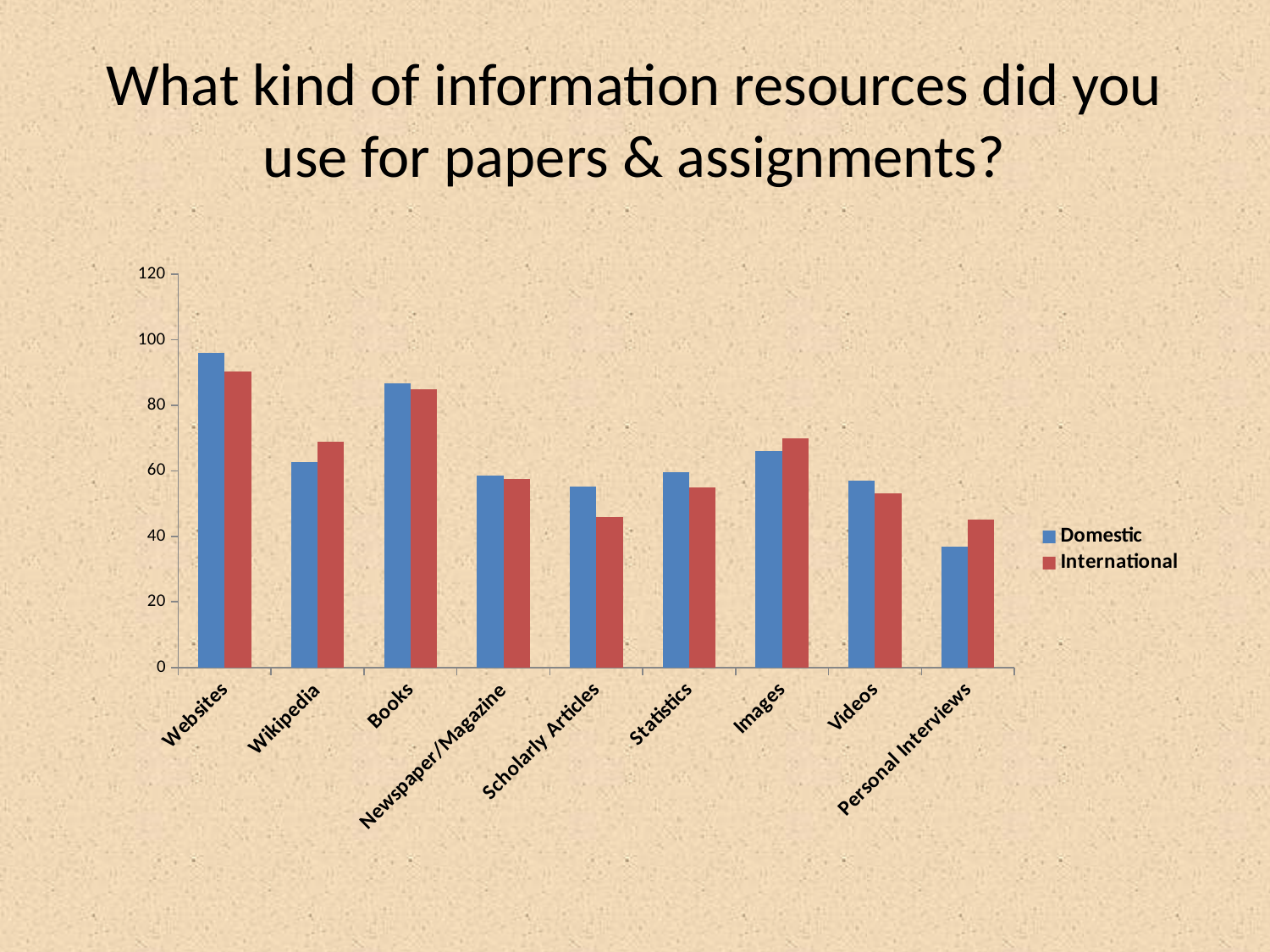
How many series does the legend list? 2 Which category has the lowest Domestic value? Personal Interviews For Scholarly Articles, which is larger, the Domestic or the International value? Domestic Is the Domestic value for Websites greater or less than 80? greater Is the Domestic value for Personal Interviews greater or less than 40? less What are the two series named in the legend? Domestic and International Which category has the highest Domestic value? Websites Which category has the highest International value? Websites How many information resource categories are shown on the x axis? 9 What kind of chart is shown on the slide? bar chart For Wikipedia, which is larger, the Domestic or the International value? International Is the International value for Images greater or less than 60? greater